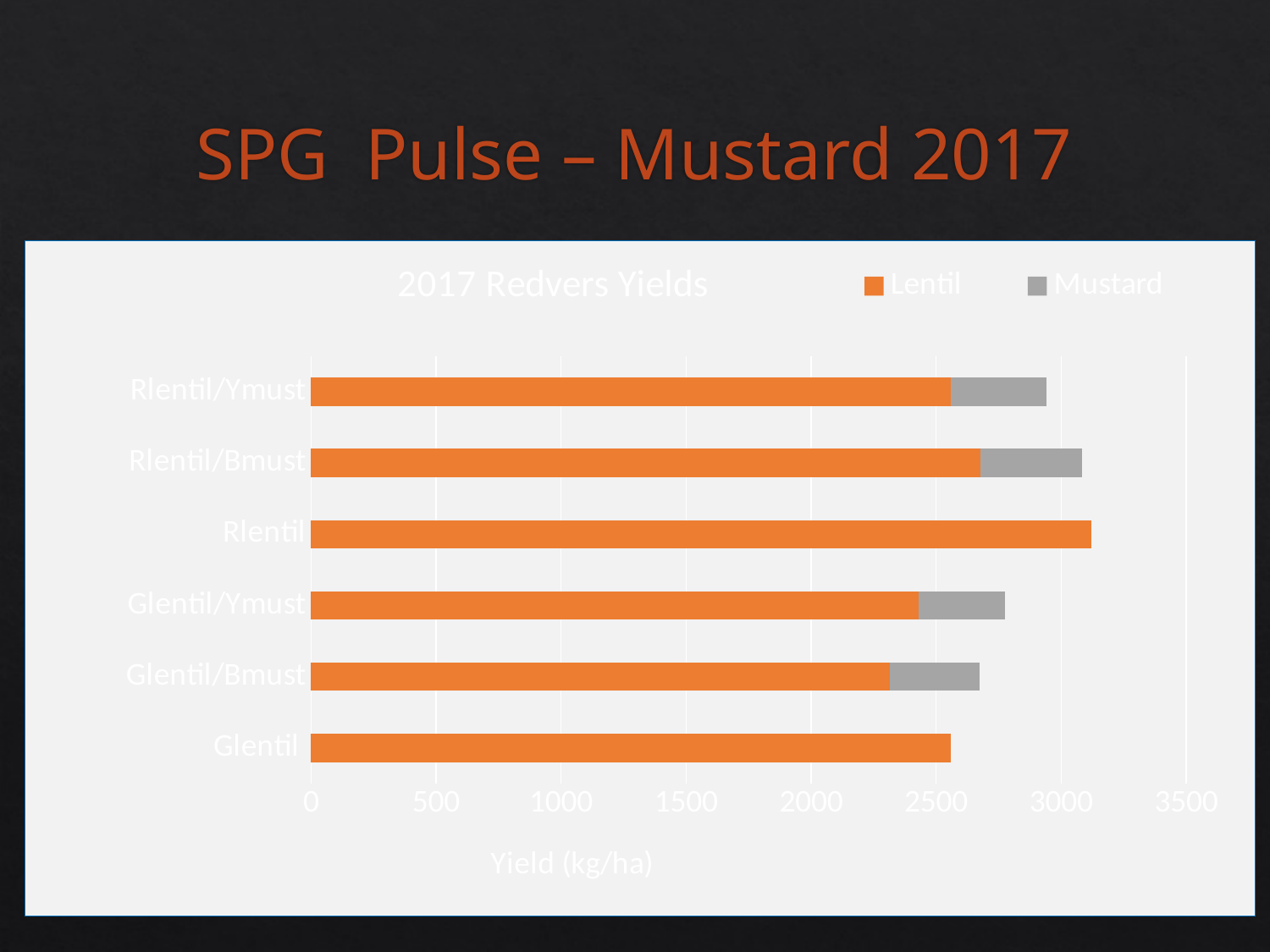
What is the title of the chart? 2017 Redvers Yields How many series does the legend list? 2 Is the Lentil yield for Glentil/Bmust greater or less than 2500? less Which has the larger Lentil yield, Rlentil or Glentil? Rlentil Which categories have no Mustard segment in their bar? Rlentil and Glentil Is the total stacked yield for Rlentil/Ymust greater or less than 3000? less Is the total stacked yield for Rlentil/Bmust greater or less than 3000? greater What is the label of the horizontal axis? Yield (kg/ha) What kind of chart is shown on the slide? Stacked horizontal bar chart Which category has the highest Lentil yield? Rlentil How many treatment categories are plotted on the chart? 6